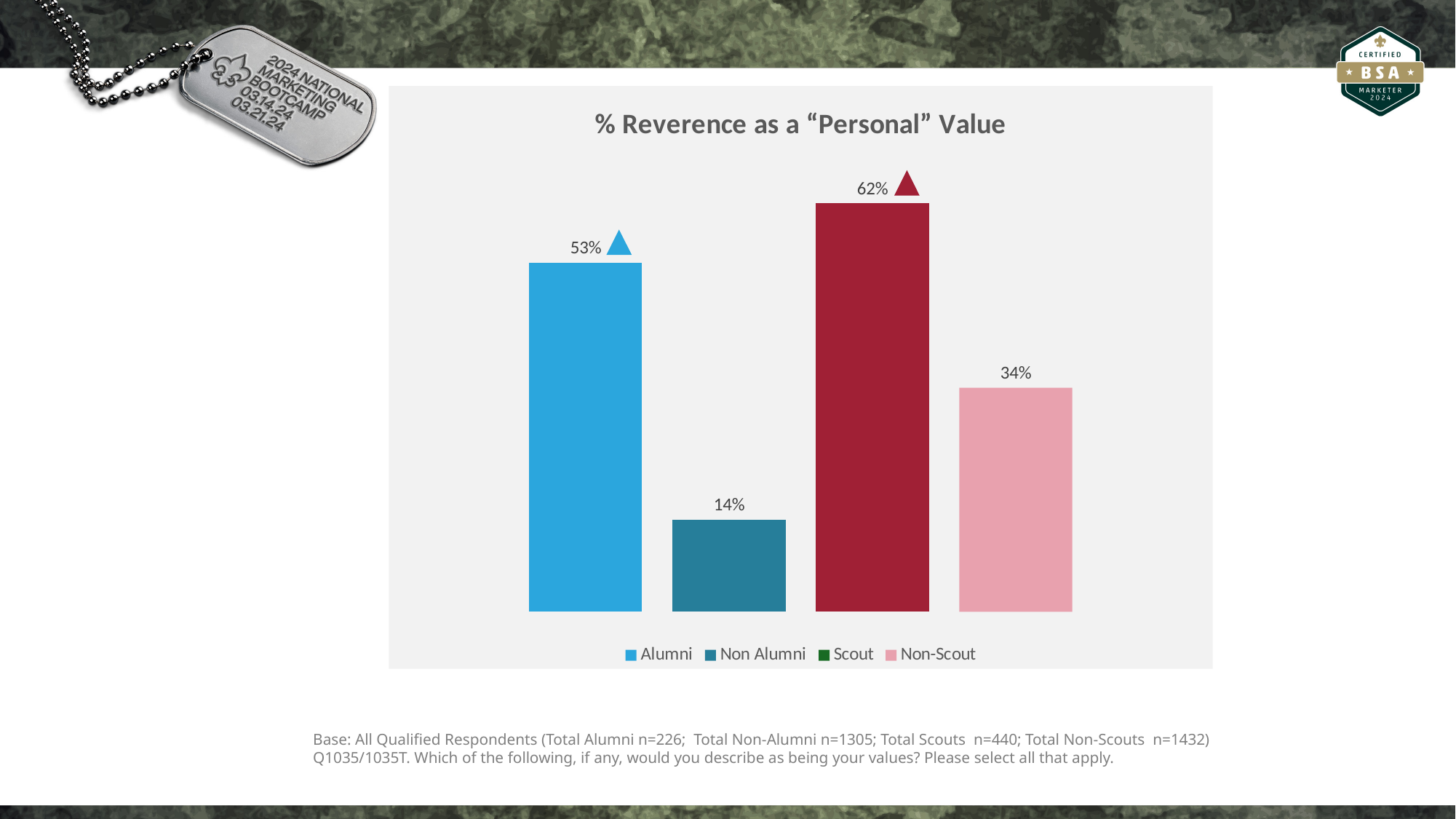
What is the value for Alumni? 53% What is the value for Non Alumni? 14% What is the title of the chart? % Reverence as a "Personal" Value Which group has the highest value? Scout What is the difference between the Scout and Non-Scout values? 28% Which group has the lowest value? Non Alumni How many entries does the legend list? 4 What is the value for Scout, the third bar? 62% Which is larger, the value for Alumni or the value for Non-Scout? Alumni What is the difference between the Alumni and Non Alumni values? 39% How many bars are plotted in the chart? 4 What is the value for Non-Scout? 34%